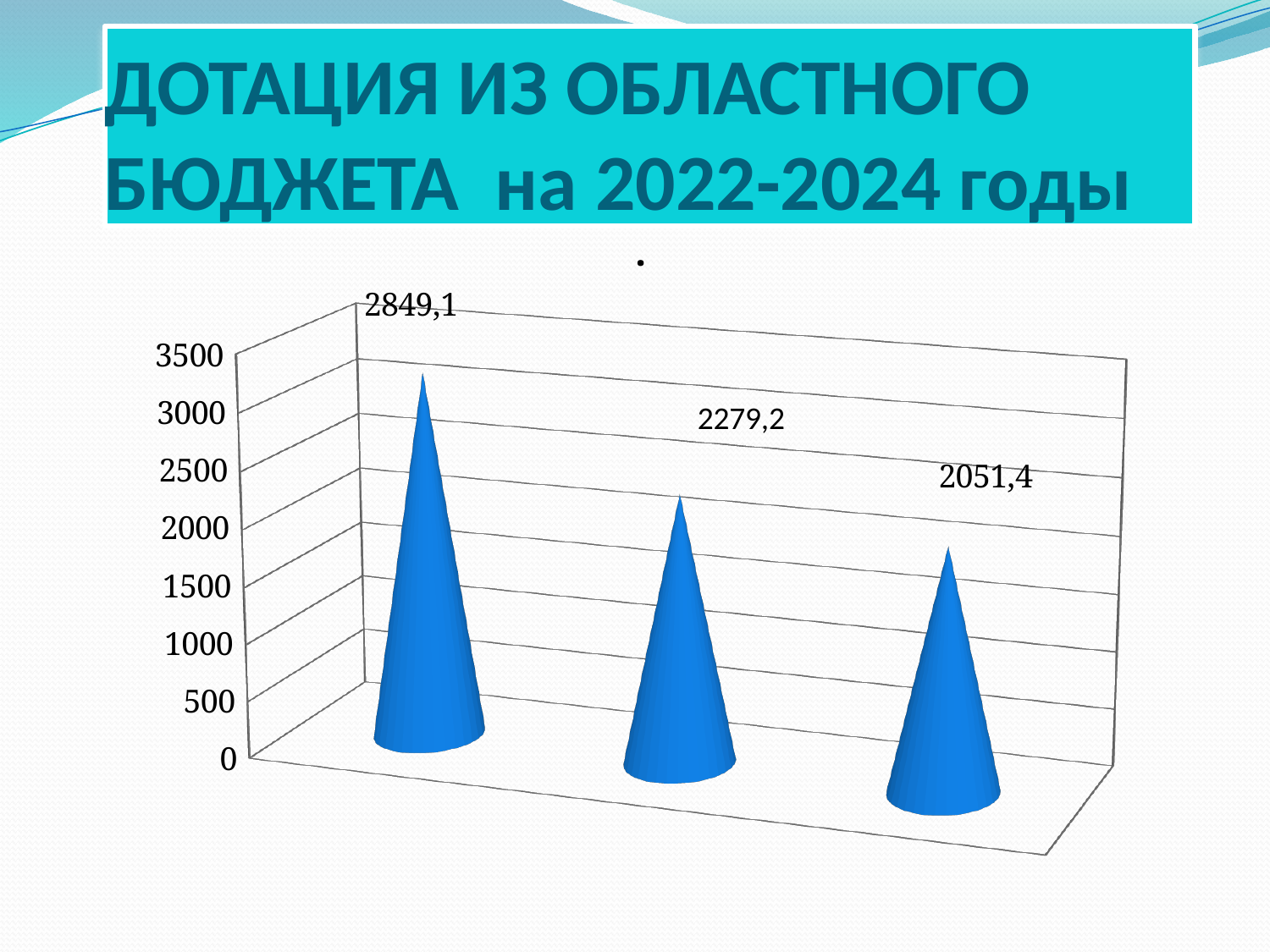
What is the difference between the leftmost bar's value and the middle bar's value? 569,9 What is the difference between the middle bar's value and the rightmost bar's value? 227,8 Do the values rise or fall from left to right across the chart? fall Is the value of the rightmost bar greater or less than 2500? less Which bar has the lowest value: the leftmost, middle or rightmost? rightmost Which is larger, the value of the middle bar or the value of the rightmost bar? middle bar What kind of chart is shown on the slide? bar chart What is the value shown on the rightmost bar of the chart? 2051,4 How many bars are plotted in the chart? 3 What is the value shown on the leftmost bar of the chart? 2849,1 Which bar has the highest value: the leftmost, middle or rightmost? leftmost What is the value shown on the middle bar of the chart? 2279,2